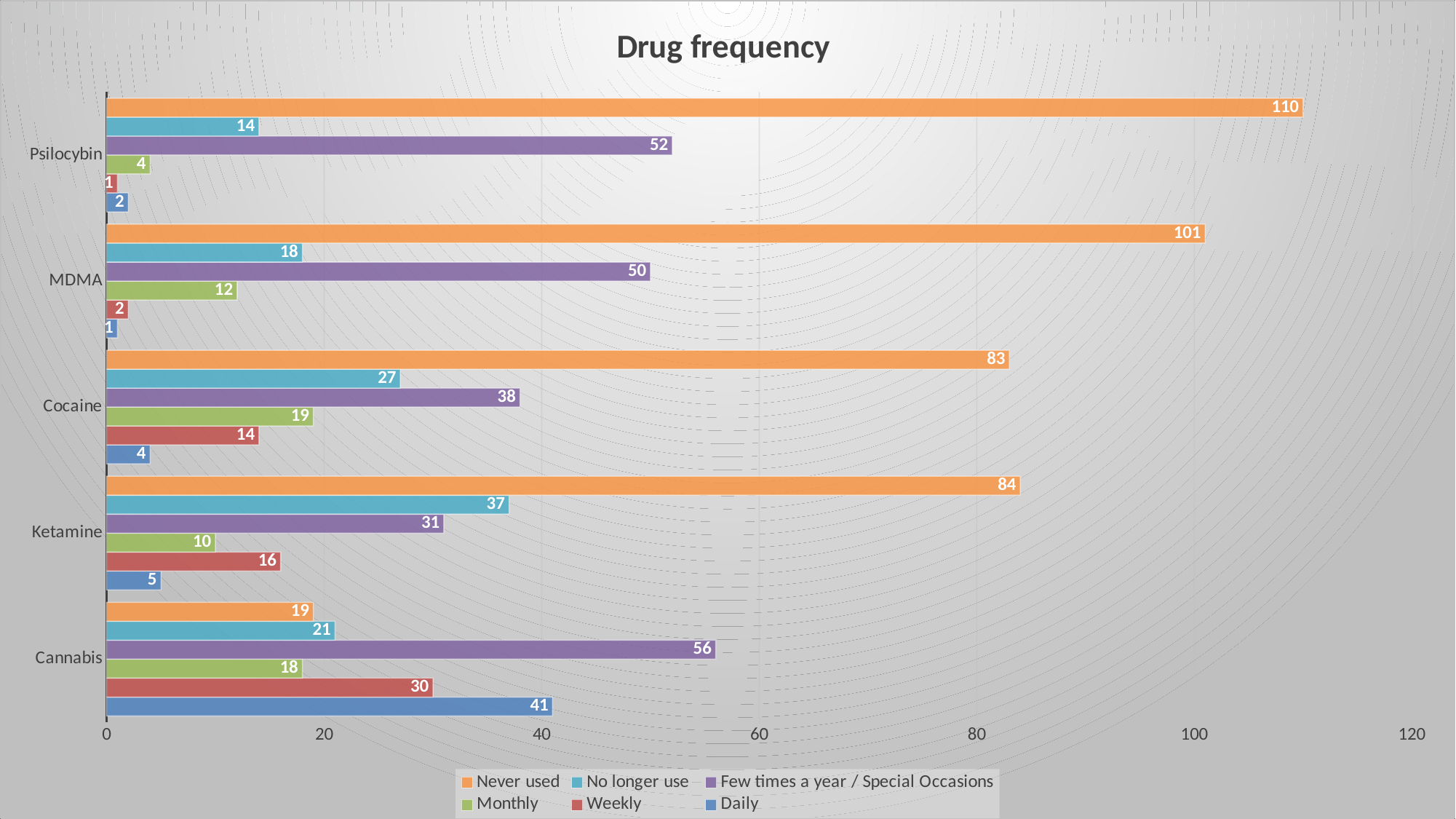
What is the 'Daily' value for Cannabis? 41 Which drug has the highest 'Never used' value? Psilocybin What is the 'Few times a year / Special Occasions' value for Cocaine? 38 What kind of chart is shown? bar chart Which is larger: the 'No longer use' value for Ketamine or for Cocaine? Ketamine Is the 'Few times a year / Special Occasions' value for Cannabis greater or less than 40? greater How many drug categories are shown on the chart? 5 What is the difference between the 'Never used' values for MDMA and Cocaine? 18 What is the title of the chart? Drug frequency What is the value for 'Never used' for Psilocybin? 110 Which drug has the lowest 'Never used' value? Cannabis How many series does the legend list? 6